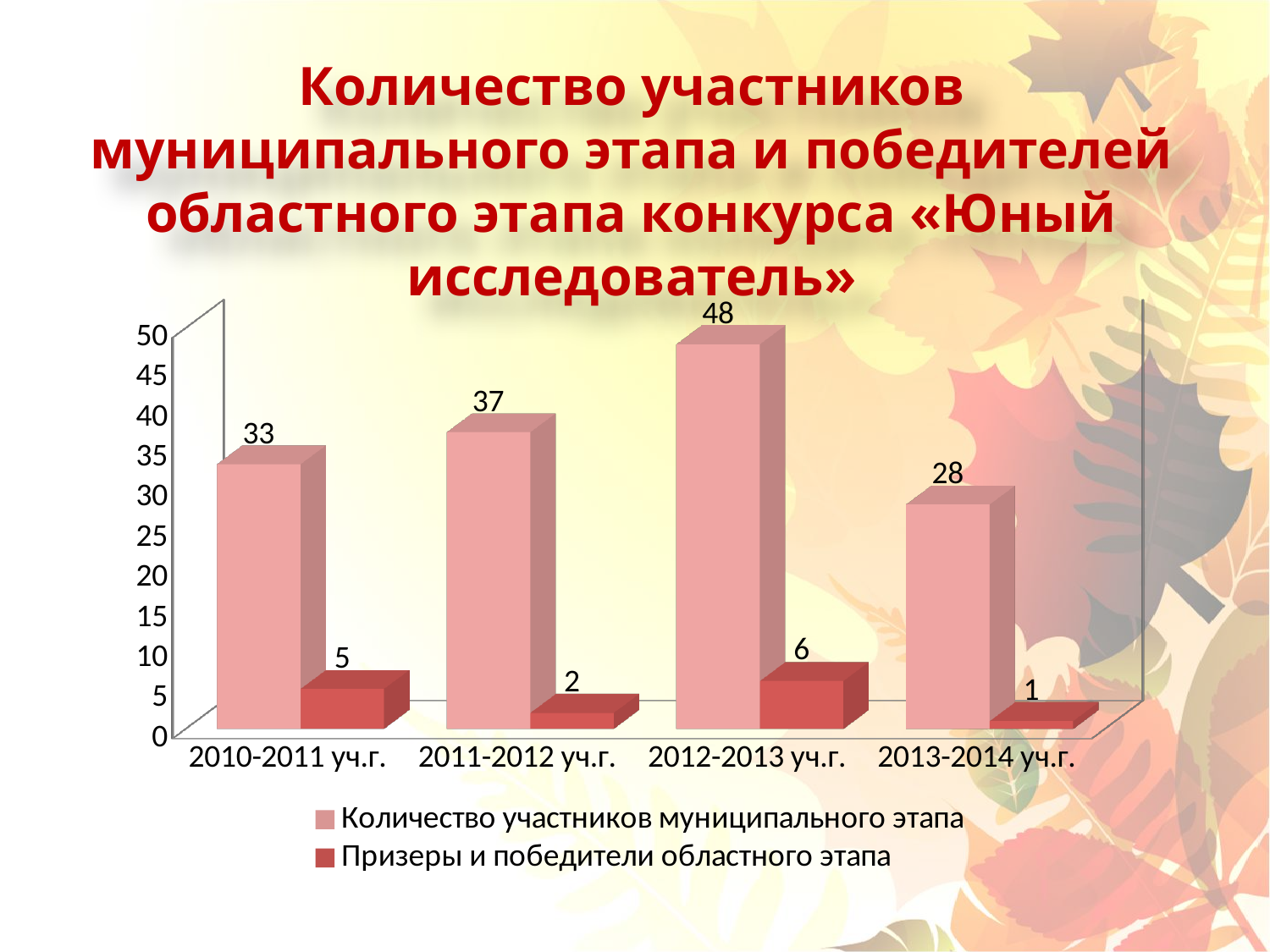
How many participants of the municipal stage were there in 2012-2013 уч.г.? 48 How many prize-winners and winners of the regional stage (Призеры и победители областного этапа) were there in 2010-2011 уч.г.? 5 What is the difference between the number of municipal stage participants in 2012-2013 уч.г. and 2013-2014 уч.г.? 20 What kind of chart is shown on the slide? Bar chart How many series does the legend list? 2 What is the value for Количество участников муниципального этапа in 2013-2014 уч.г.? 28 How many academic years are shown on the x axis? 4 Which is larger: the number of municipal stage participants in 2010-2011 уч.г. or in 2011-2012 уч.г.? 2011-2012 уч.г. Which series is shown in the darker red colour? Призеры и победители областного этапа Which academic year has the lowest number of regional stage prize-winners and winners? 2013-2014 уч.г. Which academic year has the highest number of municipal stage participants? 2012-2013 уч.г. What is the total of the two values shown for 2011-2012 уч.г.? 39